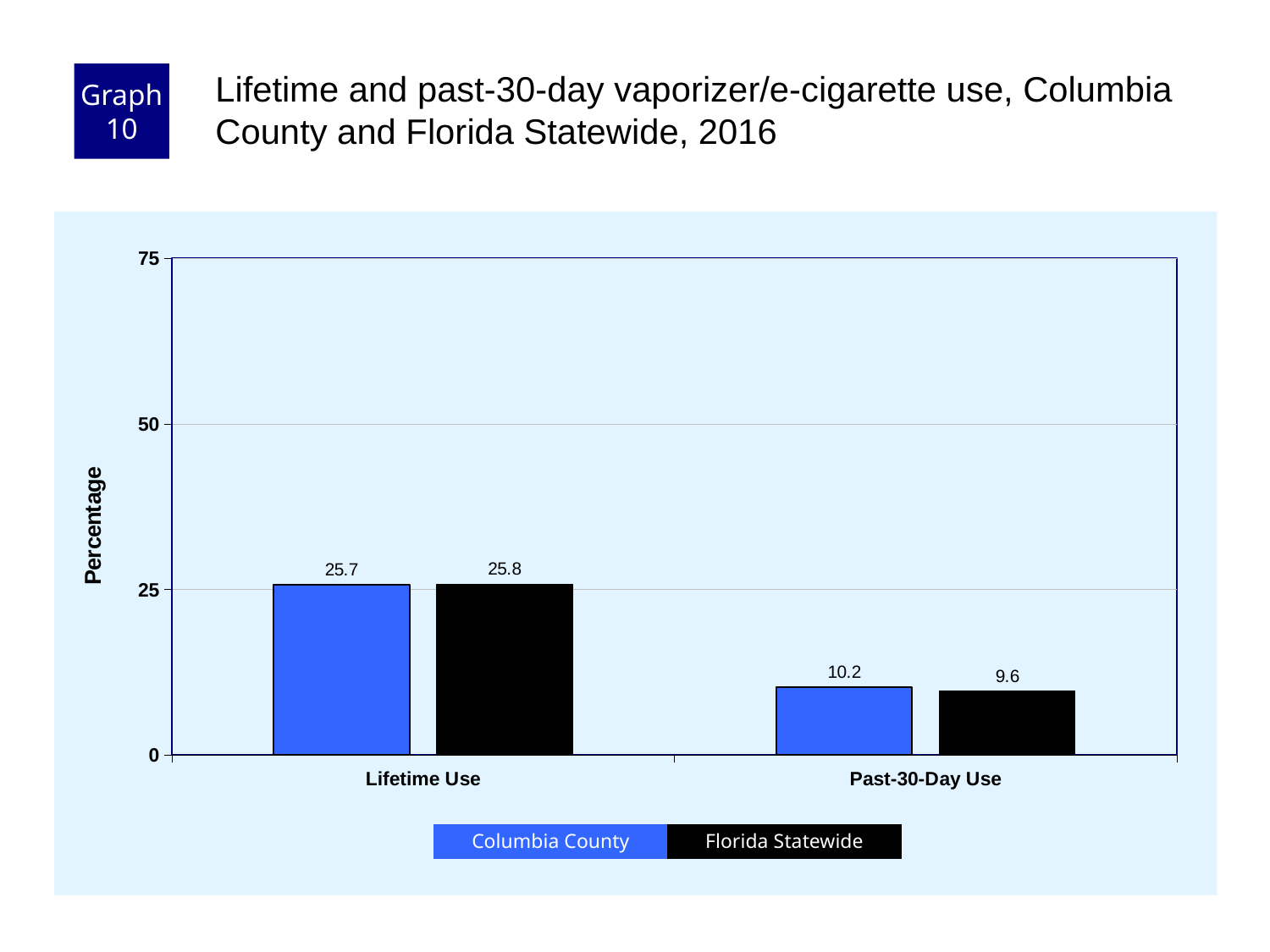
What is the difference between the Columbia County values for Lifetime Use and Past-30-Day Use? 15.5 What is the Columbia County value for Lifetime Use? 25.7 What is the Florida Statewide value for Past-30-Day Use? 9.6 What is the Columbia County value for Past-30-Day Use? 10.2 Is the Florida Statewide value for Lifetime Use greater or less than 50? less How many categories are shown on the x axis? 2 What kind of chart is shown on the slide? bar chart Which category has the highest Columbia County value? Lifetime Use How many series does the legend list? 2 What is the difference between the Columbia County and Florida Statewide values for Past-30-Day Use? 0.6 Which category has the lowest Florida Statewide value? Past-30-Day Use What is the Florida Statewide value for Lifetime Use? 25.8